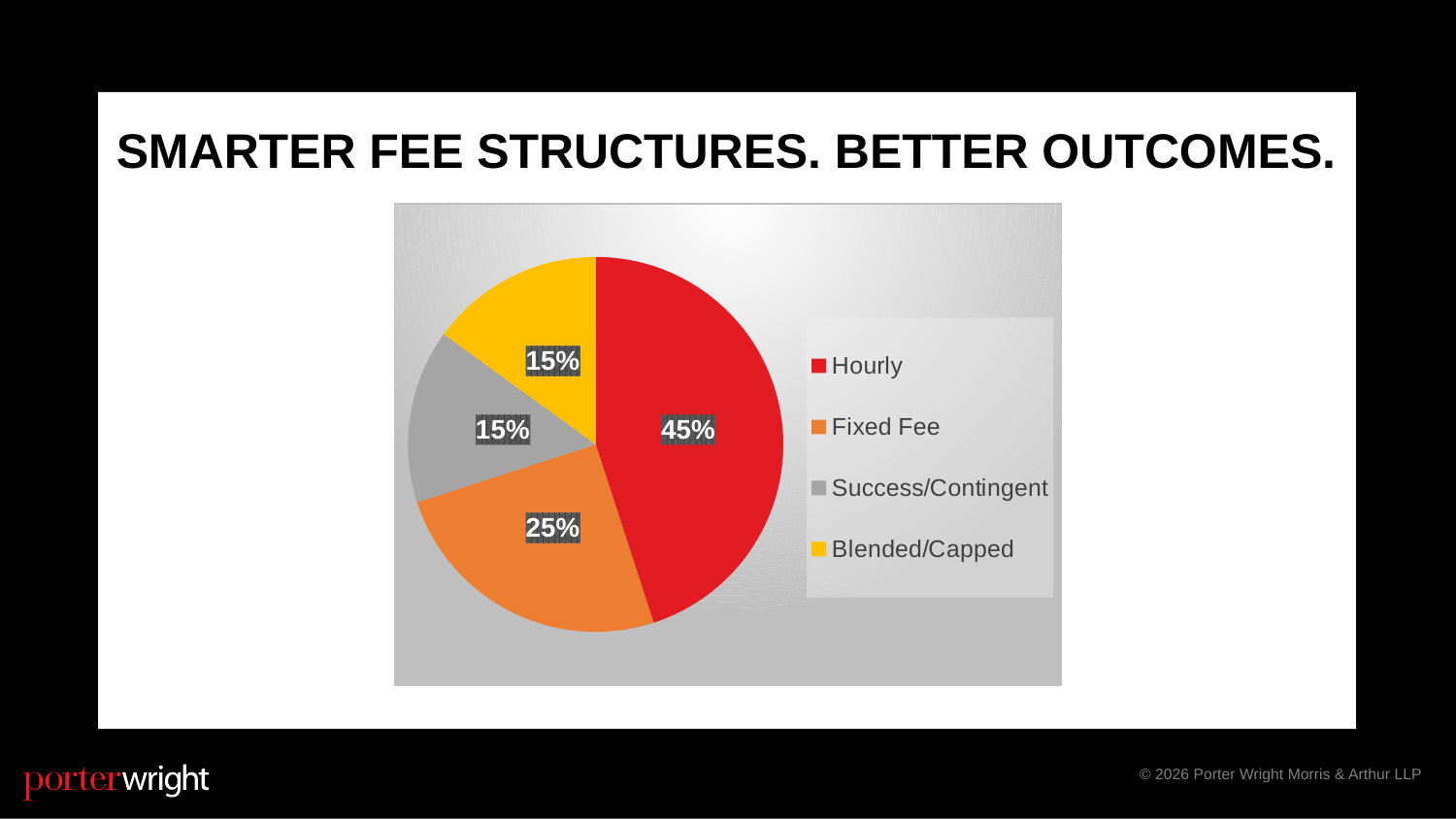
What kind of chart is shown on the slide? Pie chart How many slices does the pie chart have? 4 What share of the pie does Hourly represent? 45% How many entries does the legend list? 4 What is the title of the slide containing the pie chart? SMARTER FEE STRUCTURES. BETTER OUTCOMES. What share of the pie does Blended/Capped represent? 15% What share of the pie does Success/Contingent represent? 15% Which is larger, the Fixed Fee slice or the Blended/Capped slice? Fixed Fee Which fee structure has the largest slice of the pie? Hourly What is the difference in percentage points between the Hourly and Fixed Fee slices? 20 percentage points What colour is the Hourly slice in the pie chart? Red What share of the pie does Fixed Fee represent? 25%